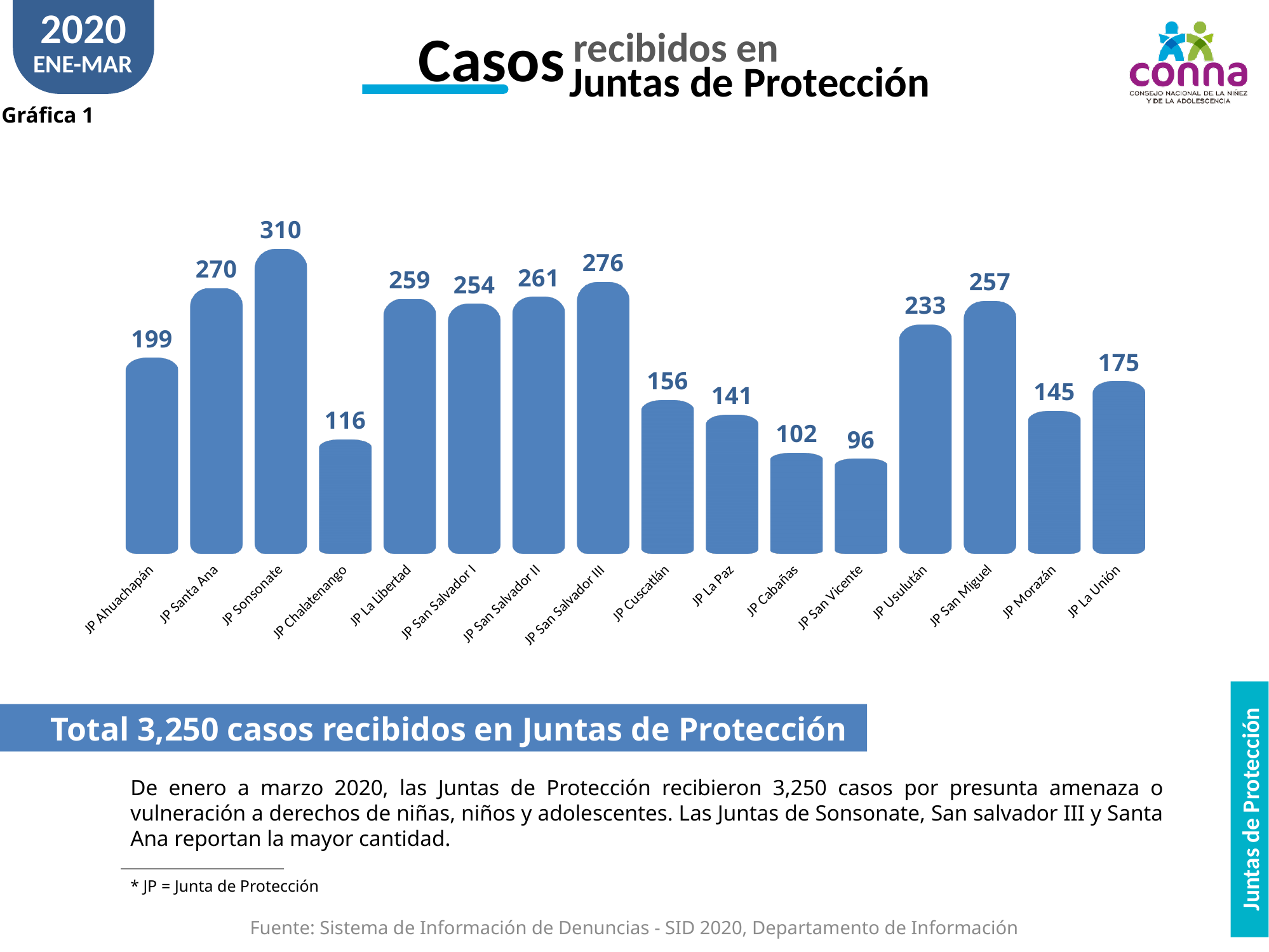
Which Junta de Protección has the highest number of cases? JP Sonsonate How many cases were received by JP Sonsonate? 310 Which Junta de Protección has the lowest number of cases? JP San Vicente How many Juntas de Protección are shown on the chart? 16 Which has more cases, JP La Paz or JP La Unión? JP La Unión What is the difference between the cases for JP Sonsonate and JP San Vicente? 214 How many cases are shown for JP San Salvador III? 276 What kind of chart is shown on the slide? Bar chart What is the total number of cases received in Juntas de Protección according to the slide? 3,250 What is the difference between the values for JP Santa Ana and JP Ahuachapán? 71 What is the value shown for JP Chalatenango? 116 Which has more cases, JP Usulután or JP San Miguel? JP San Miguel